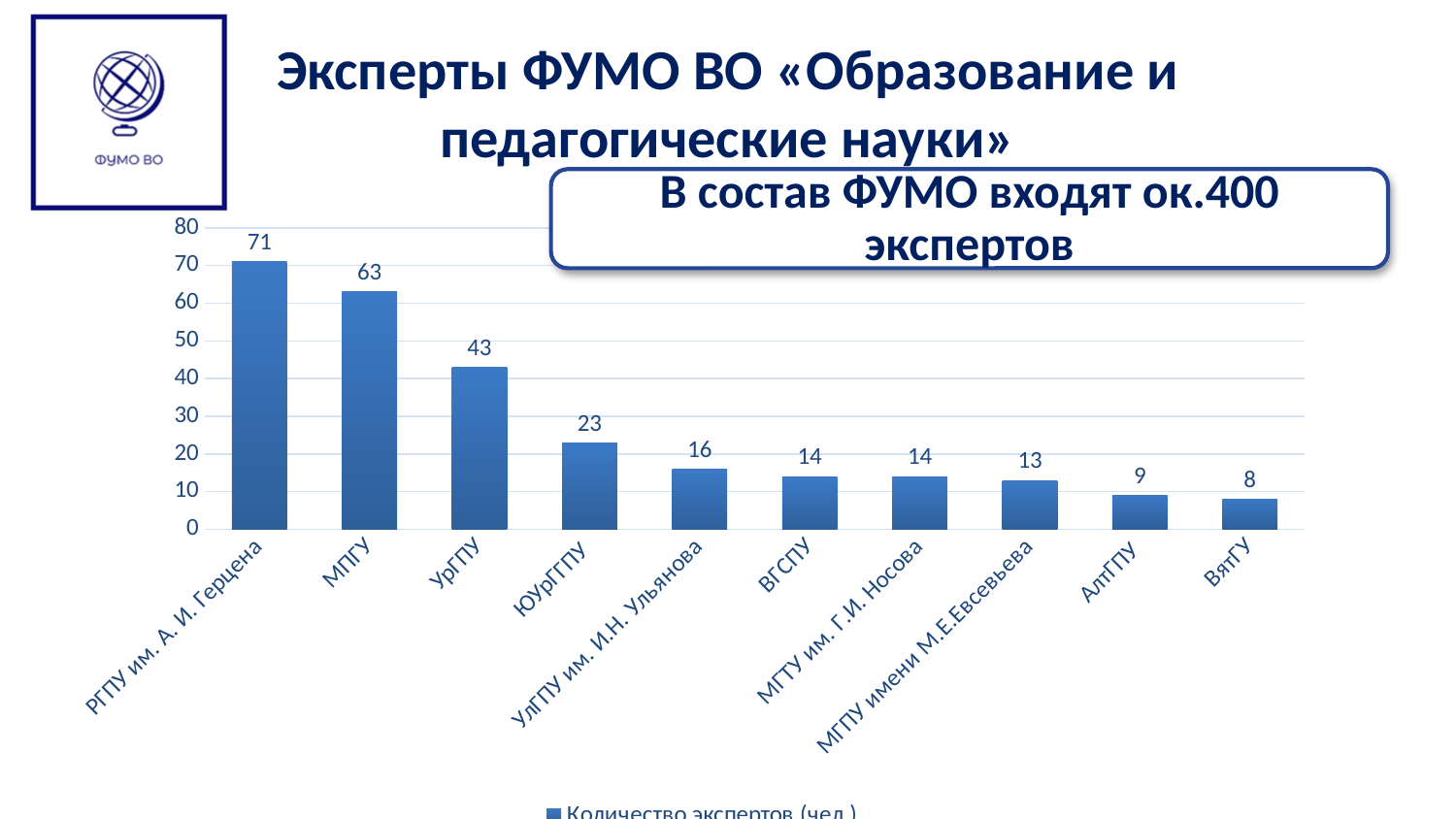
What kind of chart is shown on the slide? Bar chart Which university has the lowest value in the chart? ВятГУ How many experts does the chart show for МПГУ? 63 What is the value shown for УрГПУ? 43 What value is labelled for ЮУрГГПУ? 23 What series name does the legend show? Количество экспертов (чел.) Do the values rise or fall from left to right along the x axis? Fall What is the difference between the values for ВГСПУ and МГПУ имени М.Е.Евсевьева? 1 What is the difference between the values for РГПУ им. А. И. Герцена and МПГУ? 8 How many universities (categories) are shown in the chart? 10 Which university has the highest number of experts in the chart? РГПУ им. А. И. Герцена Which has a larger value, УлГПУ им. И.Н. Ульянова or АлтГПУ? УлГПУ им. И.Н. Ульянова